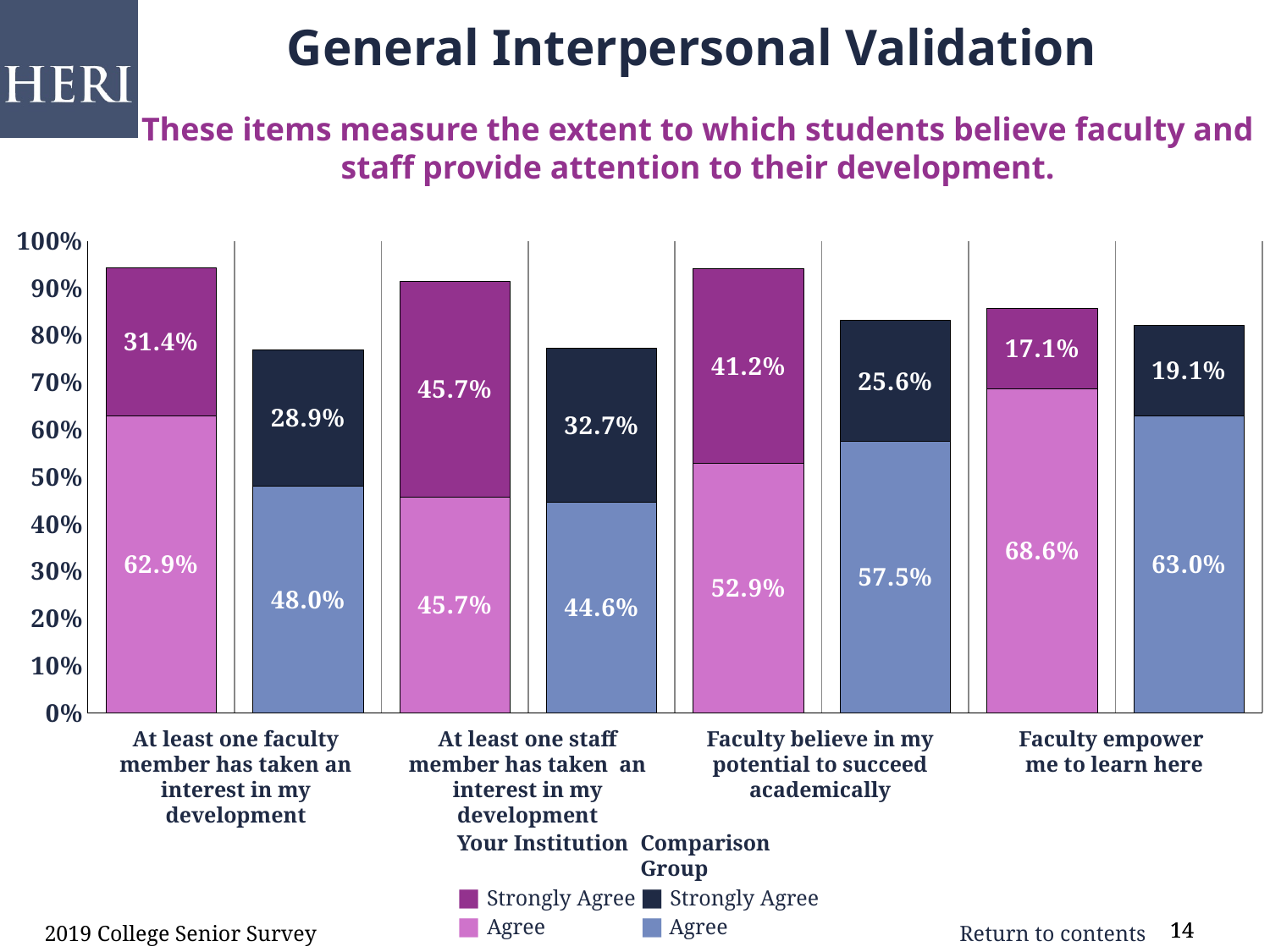
Across the four items, which has the highest Your Institution Strongly Agree value? At least one staff member has taken an interest in my development What percentage of the Comparison Group agree that faculty empower them to learn here? 63.0% What is the combined Agree plus Strongly Agree total for Your Institution on 'At least one faculty member has taken an interest in my development'? 94.3% How many series does the legend list? 4 Which has the larger Strongly Agree value for 'Faculty empower me to learn here': Your Institution or the Comparison Group? Comparison Group What is the difference between the Your Institution and Comparison Group Strongly Agree values for 'At least one staff member has taken an interest in my development'? 13.0% What percentage of Your Institution students strongly agree that at least one faculty member has taken an interest in their development? 31.4% What percentage of Your Institution students agree that faculty believe in their potential to succeed academically? 52.9% What kind of chart is shown on the slide? Stacked bar chart Across the four items, which has the lowest Comparison Group Strongly Agree value? Faculty empower me to learn here How many survey items (categories) are shown on the x axis? 4 What is the combined Agree plus Strongly Agree total for the Comparison Group on 'Faculty empower me to learn here'? 82.1%